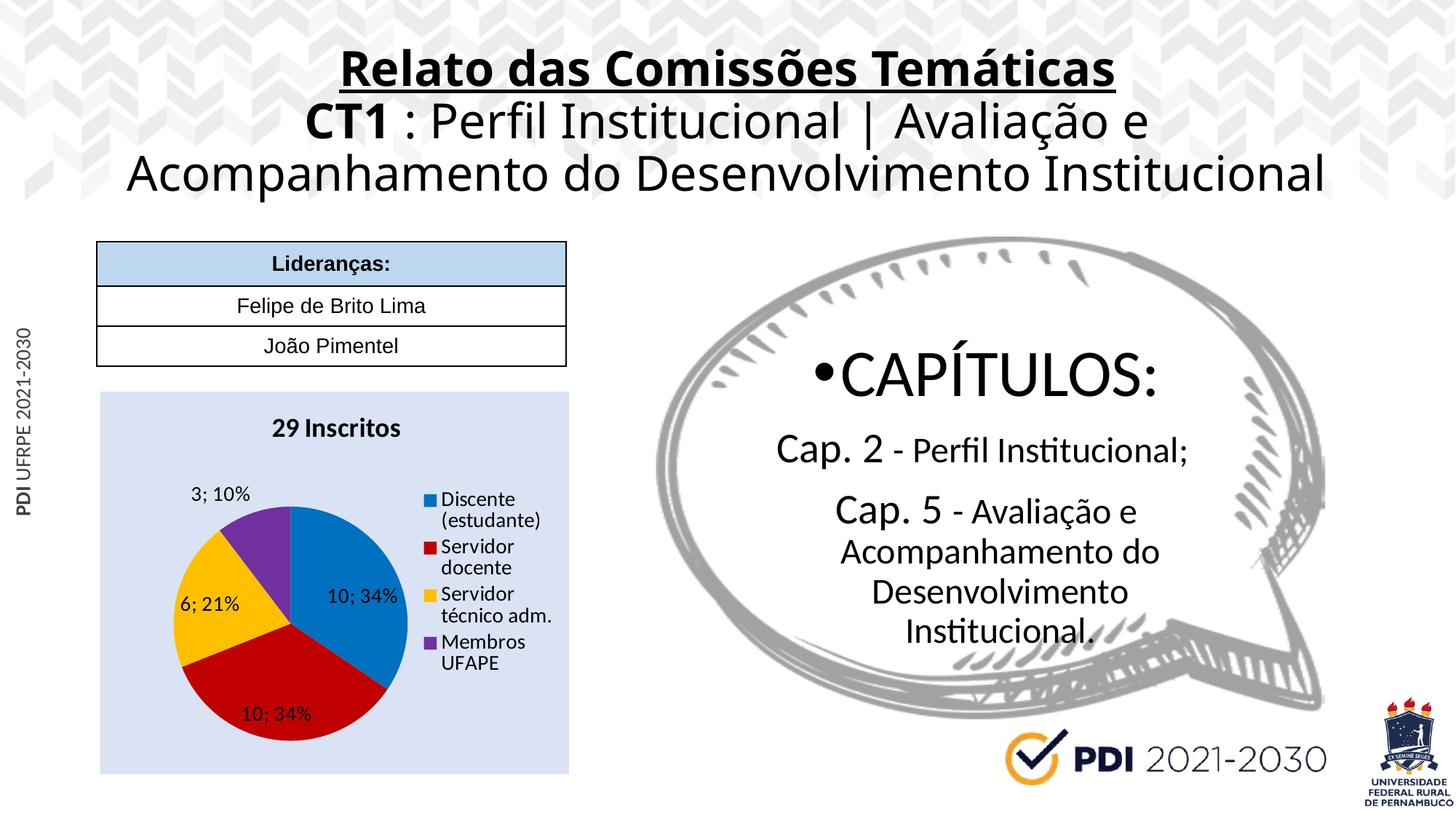
Which category has the smallest slice in the pie chart? Membros UFAPE How many categories does the pie chart have? 4 What kind of chart is shown on the slide? pie chart What is the title of the pie chart? 29 Inscritos What share of the pie does Servidor docente represent? 34% Which is larger in the pie chart, Servidor técnico adm. or Membros UFAPE? Servidor técnico adm. What is the difference between the values for Servidor docente and Membros UFAPE in the pie chart? 7 What is the value for Discente (estudante) in the pie chart? 10 What share of the pie does Servidor técnico adm. represent? 21% How many entries does the legend of the pie chart list? 4 What is the value for Servidor técnico adm. in the pie chart? 6 What is the value for Membros UFAPE in the pie chart? 3